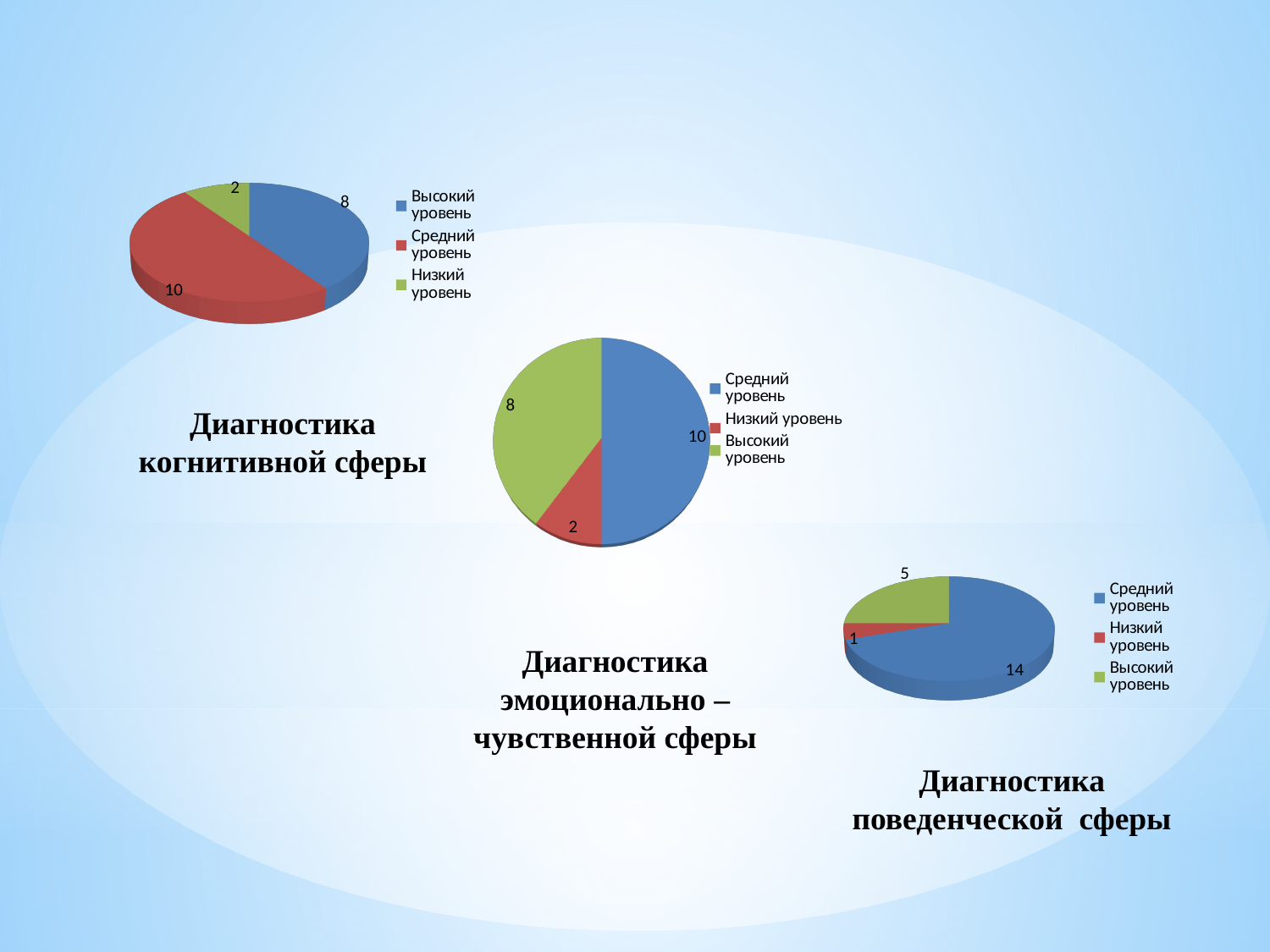
In the 'Диагностика поведенческой сферы' chart, what share of the pie does Средний уровень represent? 70% In the 'Диагностика эмоционально – чувственной сферы' chart, how many categories are shown? 3 In the 'Диагностика поведенческой сферы' chart, which is larger, Высокий уровень or Низкий уровень? Высокий уровень In the 'Диагностика поведенческой сферы' chart, what is the difference between Средний уровень and Высокий уровень? 9 In the 'Диагностика когнитивной сферы' chart, what is the value for Средний уровень? 10 In the 'Диагностика когнитивной сферы' chart, what is the difference between Средний уровень and Высокий уровень? 2 In the 'Диагностика когнитивной сферы' chart, what colour represents Высокий уровень? Blue In the 'Диагностика поведенческой сферы' chart, what is the value for Низкий уровень? 1 What type of chart is used for 'Диагностика когнитивной сферы'? Pie chart In the 'Диагностика эмоционально – чувственной сферы' chart, what is the value for Высокий уровень? 8 In the 'Диагностика когнитивной сферы' chart, which category has the smallest value? Низкий уровень In the 'Диагностика эмоционально – чувственной сферы' chart, which category has the largest value? Средний уровень